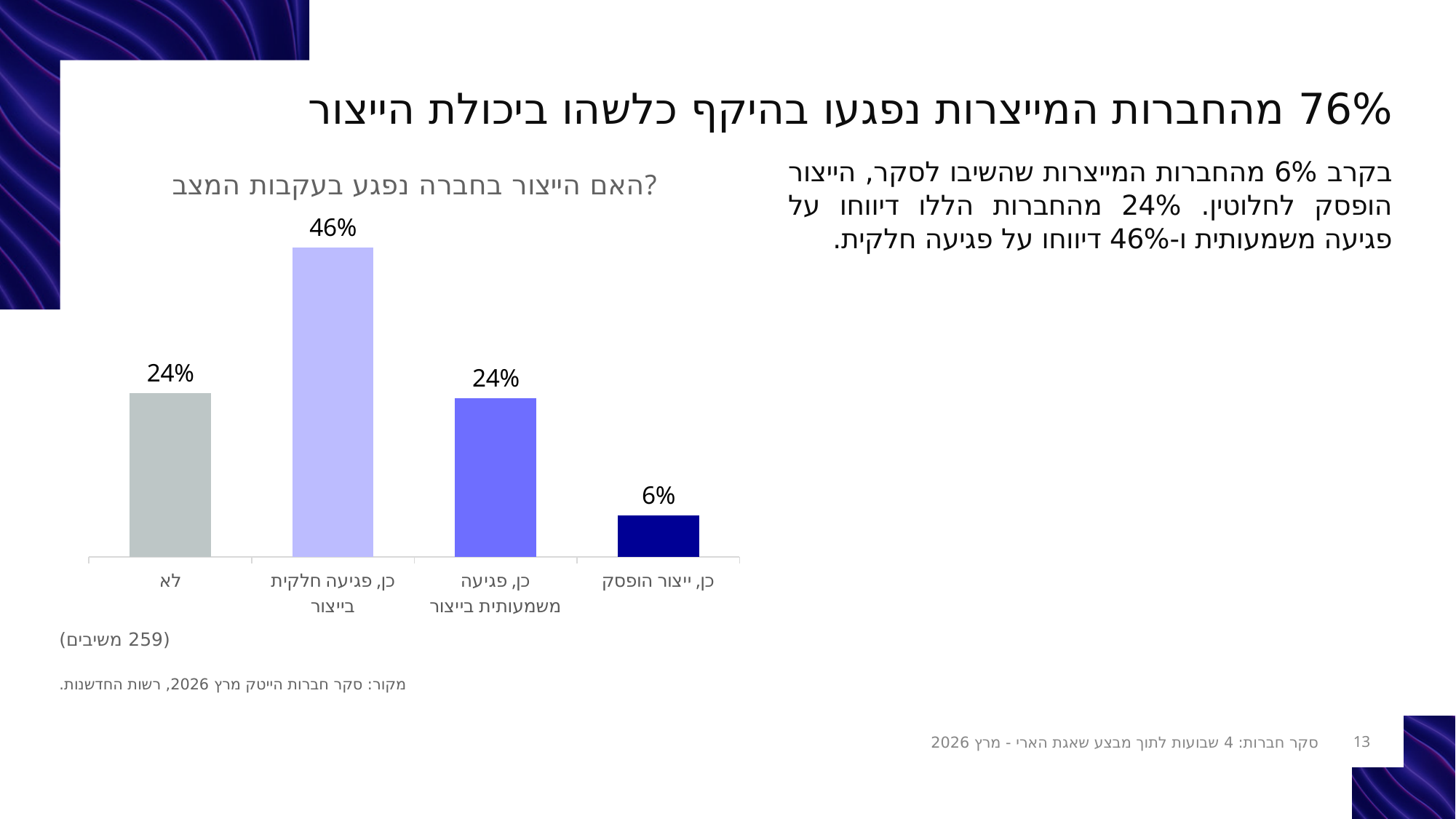
What is the difference between the values for "כן, פגיעה חלקית בייצור" and "לא"? 22 percentage points How many categories are shown in the chart? 4 What kind of chart is shown on the slide? Bar chart What value is shown for the category "לא"? 24% Which category has the highest value? כן, פגיעה חלקית בייצור Which is larger: the value for "כן, פגיעה חלקית בייצור" or the value for "כן, ייצור הופסק"? כן, פגיעה חלקית בייצור What value is shown for the category "כן, פגיעה חלקית בייצור"? 46% What value is shown for the category "כן, ייצור הופסק"? 6% What is the difference between the values for "כן, פגיעה משמעותית בייצור" and "כן, ייצור הופסק"? 18 percentage points What is the title of the chart? האם הייצור בחברה נפגע בעקבות המצב? What value is shown for the category "כן, פגיעה משמעותית בייצור"? 24% Which category has the lowest value? כן, ייצור הופסק